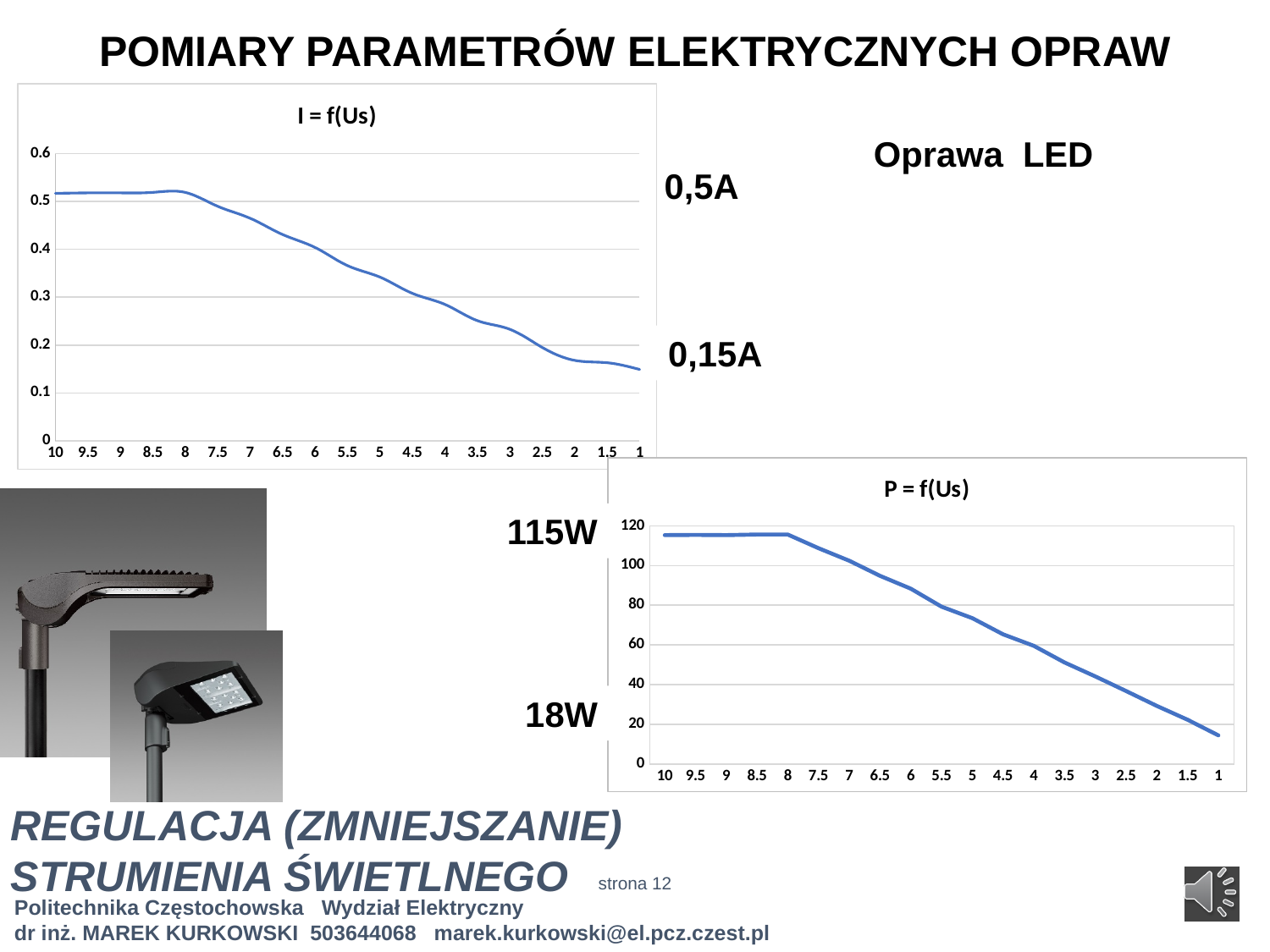
In the "P = f(Us)" chart, is the value at x = 10 greater or less than 100? greater What is the title of the chart in the upper left of the slide? I = f(Us) In the "I = f(Us)" chart, do the values rise or fall as you move along the x axis from 10 to 1? fall In the "P = f(Us)" chart, do the values rise or fall as you move along the x axis from 10 to 1? fall What kind of chart is the "I = f(Us)" chart? line chart In the "I = f(Us)" chart, which x value has the lower plotted value, 6 or 2? 2 How many x-axis tick labels are shown on the "P = f(Us)" chart? 19 In the "P = f(Us)" chart, is the value at x = 1 greater or less than 20? less In the "I = f(Us)" chart, is the value at x = 10 greater or less than 0.4? greater In the "P = f(Us)" chart, which x value has the higher plotted value, 8 or 4? 8 What kind of chart is the "P = f(Us)" chart? line chart